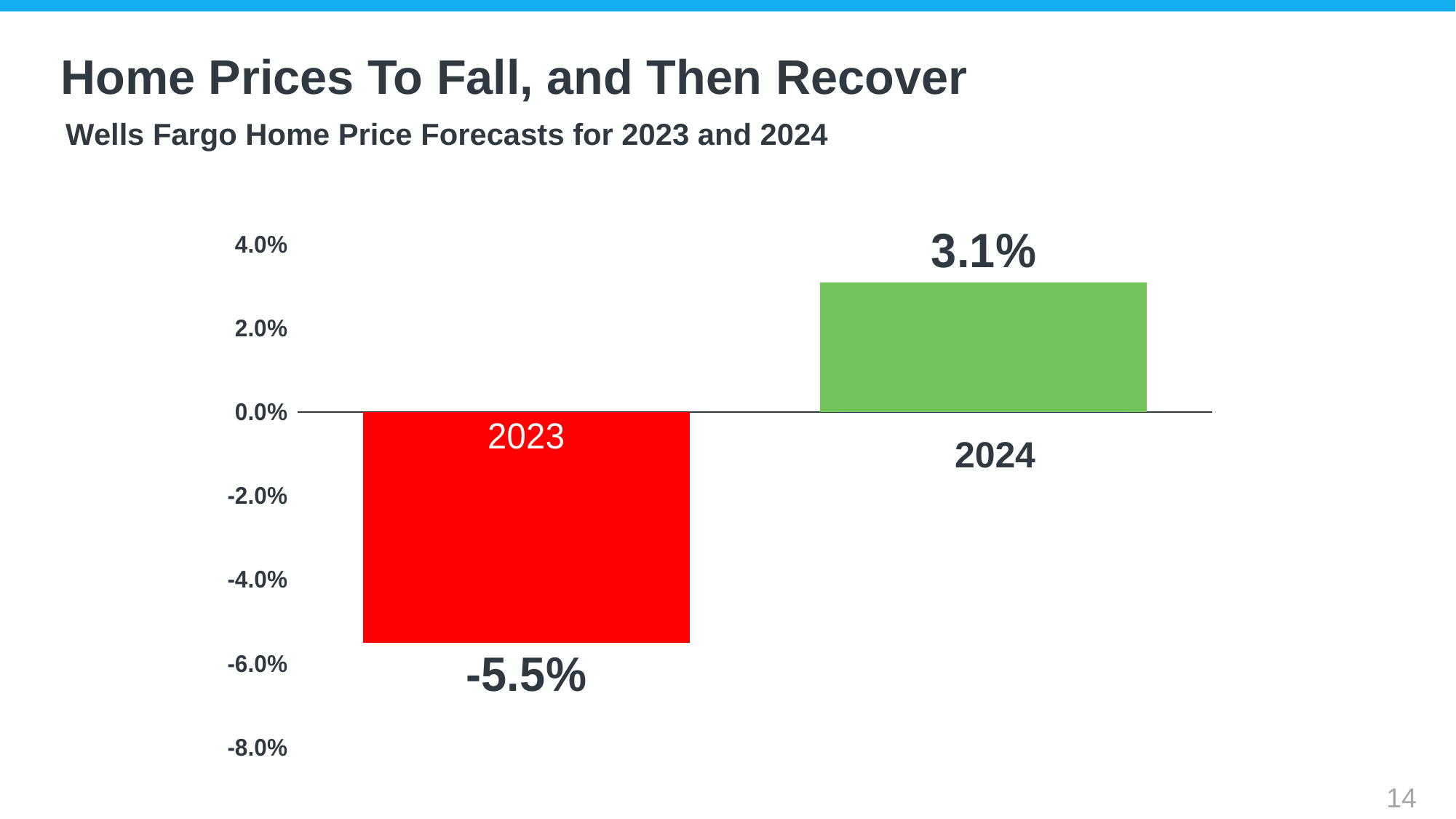
Is the value for 2024 larger than the value for 2023? Yes What colour is the bar for 2023? Red How many years are shown in the chart? 2 Do the values rise or fall from 2023 to 2024? Rise What is the difference between the 2024 and 2023 forecast values? 8.6 percentage points Is the value for 2024 greater or less than 2.0%? greater What is the forecast home price change for 2024? 3.1% What is the forecast home price change for 2023? -5.5% What kind of chart is shown on the slide? Bar chart Which year has the higher forecast value? 2024 Is the value for 2023 greater or less than -4.0%? less Which year has the lower forecast value? 2023